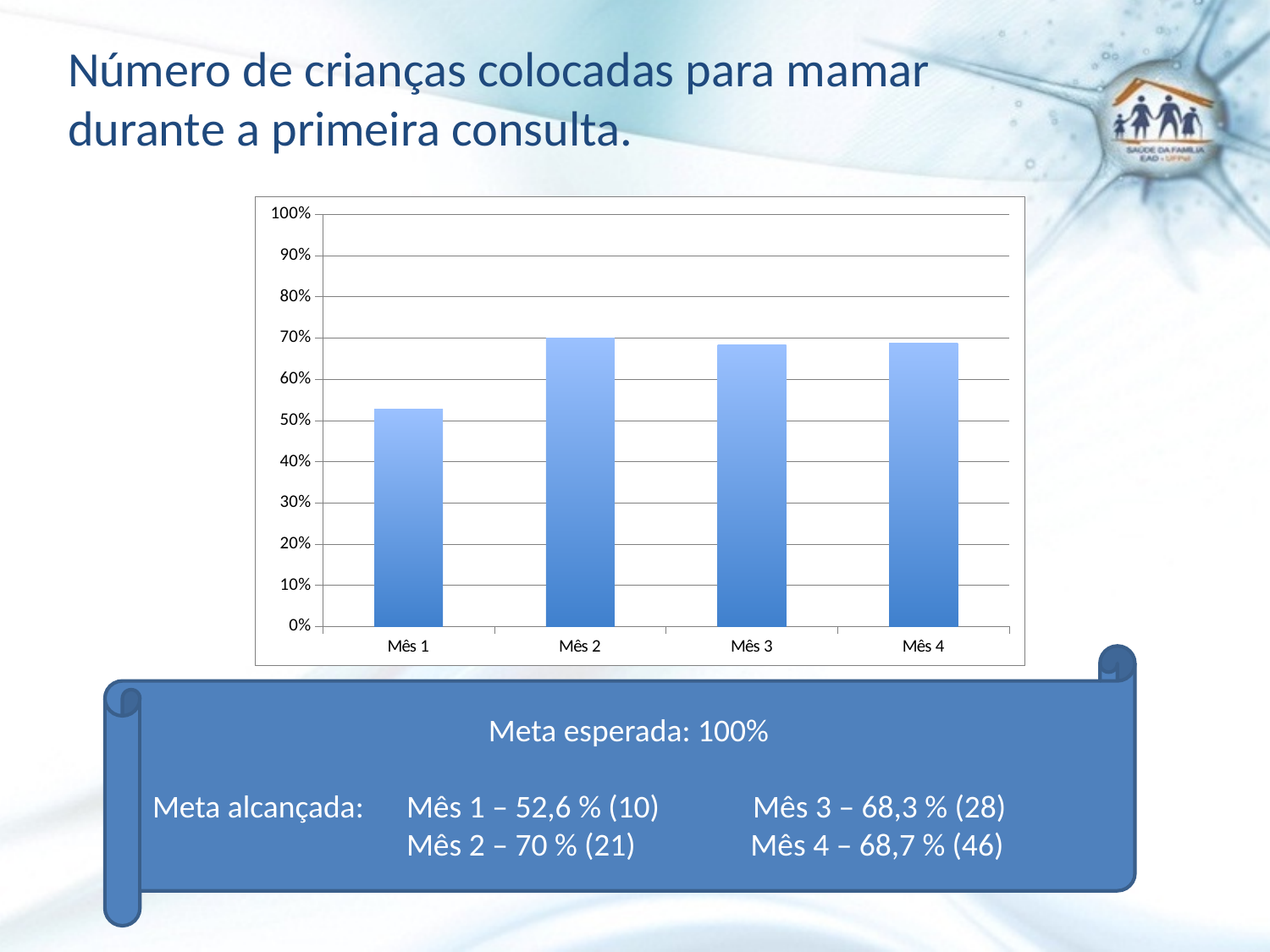
According to the slide, what percentage was reached in Mês 2? 70 % What is the expected target (meta esperada) stated on the slide? 100% What kind of chart is shown on the slide? Bar chart How many categories (months) are shown on the x axis of the chart? 4 Which month has the highest bar in the chart? Mês 2 Which is larger, the value for Mês 1 or the value for Mês 2? Mês 2 By how many percentage points does the value for Mês 2 exceed the value for Mês 1, using the figures printed on the slide? 17,4 Is the value for Mês 1 greater or less than 60%? less Which month has the lowest bar in the chart? Mês 1 According to the slide, what percentage was reached in Mês 4? 68,7 % According to the slide, what percentage was reached in Mês 1? 52,6 % Is the value for Mês 3 greater or less than 60%? greater